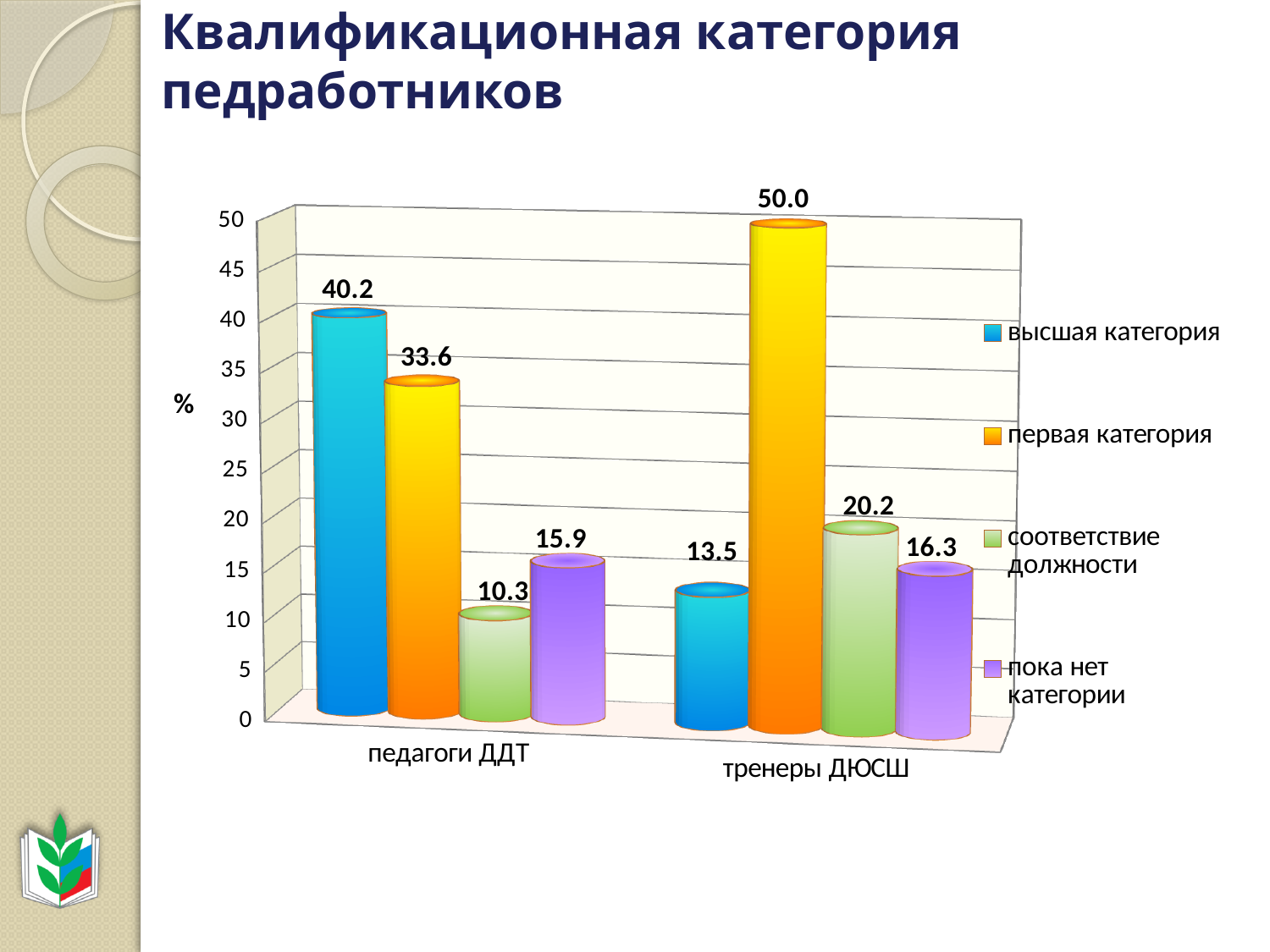
What is the title of the chart? Квалификационная категория педработников What is the value for 'соответствие должности' in the 'педагоги ДДТ' group? 10.3 What is the difference between 'высшая категория' for 'педагоги ДДТ' and for 'тренеры ДЮСШ'? 26.7 How many series does the legend list? 4 What is the value for 'высшая категория' in the 'педагоги ДДТ' group? 40.2 Which series has the highest value in the 'тренеры ДЮСШ' group? первая категория How many category groups are shown on the x axis? 2 Which is larger: 'пока нет категории' for 'педагоги ДДТ' or for 'тренеры ДЮСШ'? тренеры ДЮСШ What is the value for 'пока нет категории' in the 'тренеры ДЮСШ' group? 16.3 Which series has the lowest value in the 'педагоги ДДТ' group? соответствие должности What is the value for 'первая категория' in the 'тренеры ДЮСШ' group? 50.0 What kind of chart is shown on the slide? bar chart